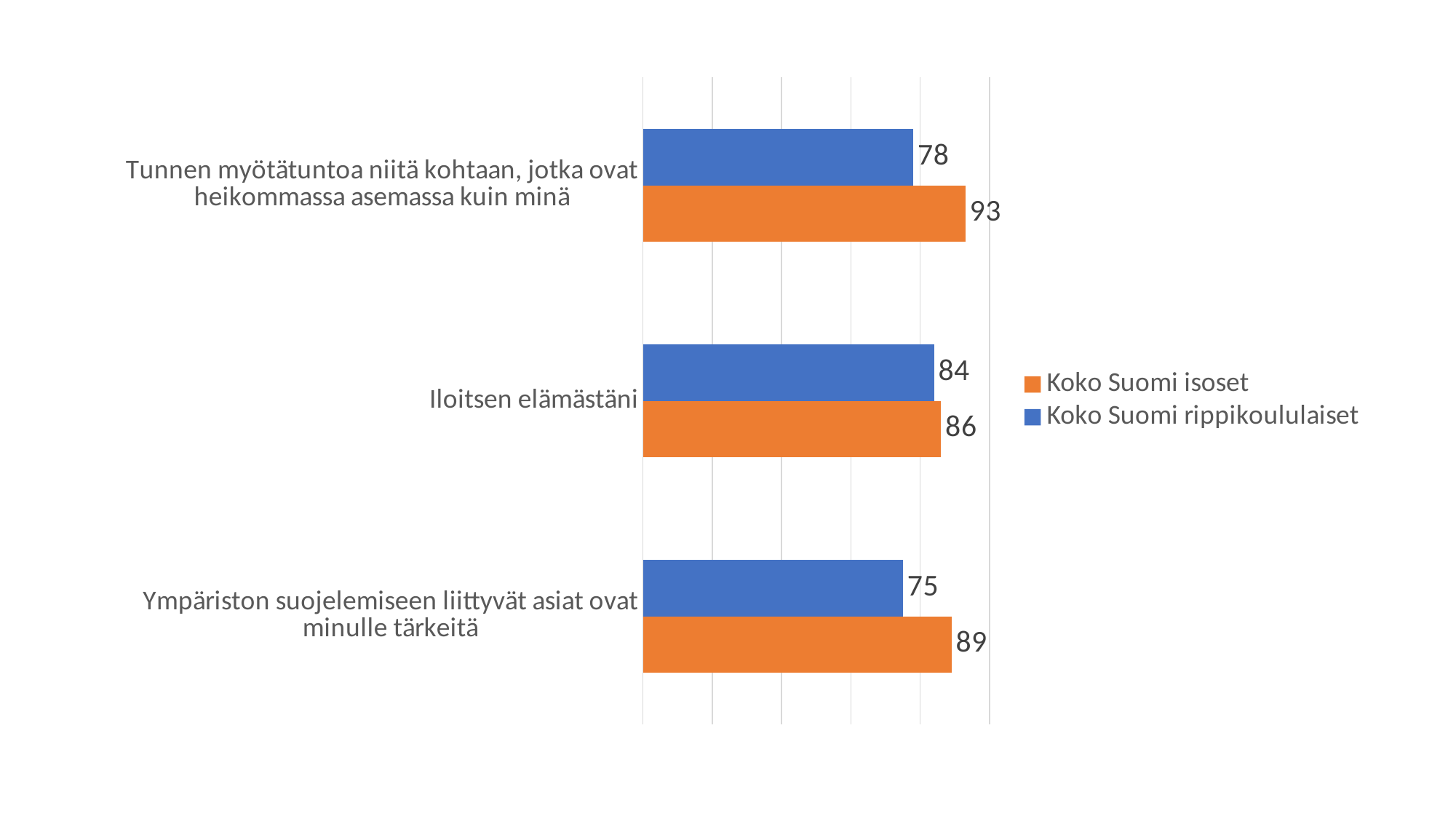
What is the value for "Koko Suomi isoset" for "Iloitsen elämästäni"? 86 How many categories are shown on the chart? 3 Which series has the larger value for "Iloitsen elämästäni"? Koko Suomi isoset How many series does the legend list? 2 What is the difference between the "Koko Suomi isoset" and "Koko Suomi rippikoululaiset" values for "Ympäriston suojelemiseen liittyvät asiat ovat minulle tärkeitä"? 14 Which category has the lowest value for "Koko Suomi rippikoululaiset"? Ympäriston suojelemiseen liittyvät asiat ovat minulle tärkeitä Which category has the highest value for "Koko Suomi isoset"? Tunnen myötätuntoa niitä kohtaan, jotka ovat heikommassa asemassa kuin minä What is the difference between the "Koko Suomi isoset" and "Koko Suomi rippikoululaiset" values for "Tunnen myötätuntoa niitä kohtaan, jotka ovat heikommassa asemassa kuin minä"? 15 What kind of chart is shown on the slide? Bar chart What is the value for "Koko Suomi rippikoululaiset" for "Iloitsen elämästäni"? 84 What is the value for "Koko Suomi rippikoululaiset" for "Ympäriston suojelemiseen liittyvät asiat ovat minulle tärkeitä"? 75 What is the value for "Koko Suomi isoset" for "Tunnen myötätuntoa niitä kohtaan, jotka ovat heikommassa asemassa kuin minä"? 93